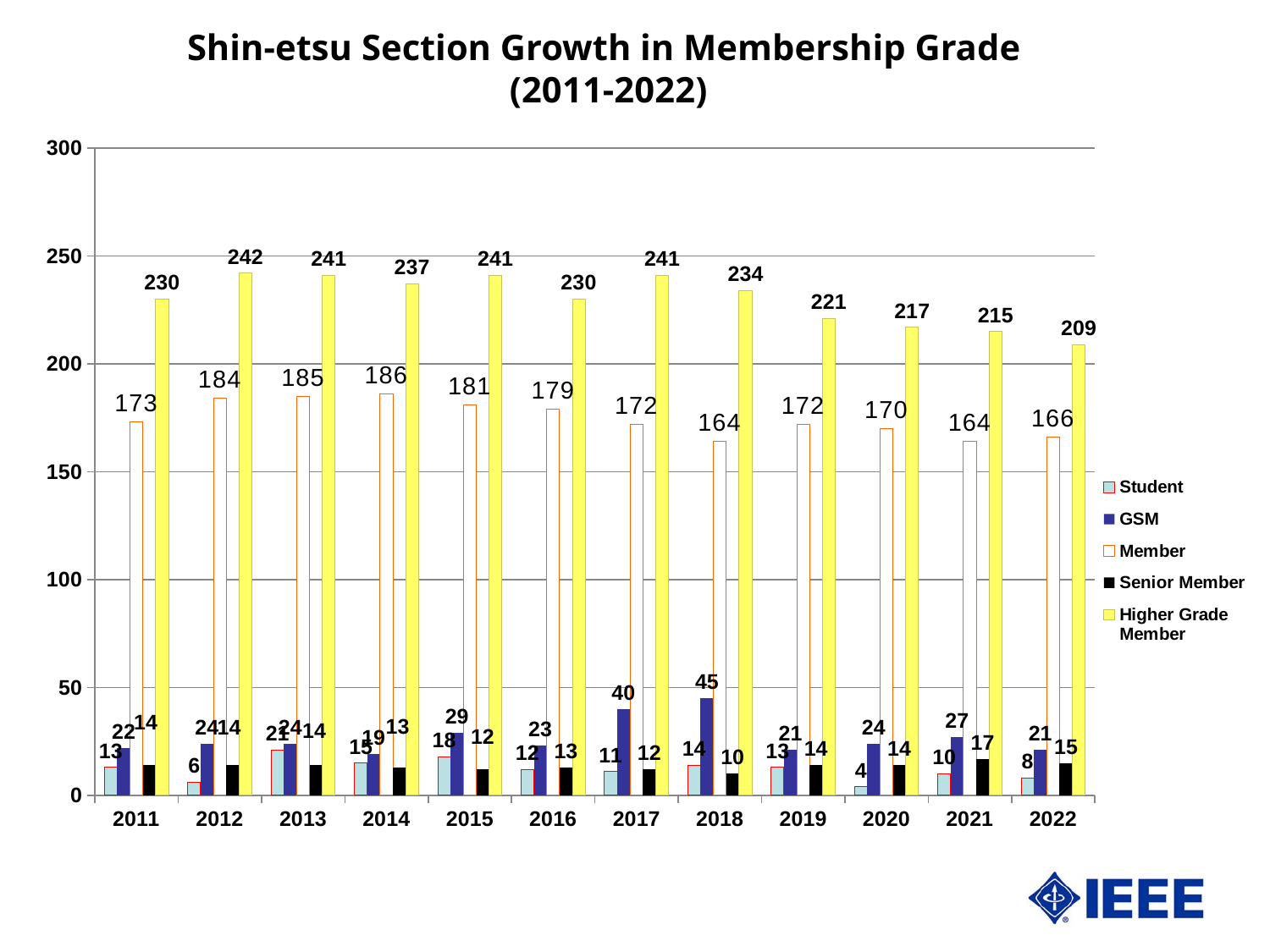
Is the value for Member in 2011 greater or less than 150? greater Which year has the larger GSM value, 2015 or 2017? 2017 What is the difference between the Member values in 2012 and 2018? 20 How many series does the legend list? 5 What is the value for Senior Member in 2021? 17 What is the value for GSM in 2018? 45 What is the value for Member in 2014? 186 In which year is the Student value lowest? 2020 How many years are shown on the x axis? 12 In which year is the Higher Grade Member value highest? 2012 What kind of chart is shown on the slide? bar chart What is the value for Higher Grade Member in 2022? 209